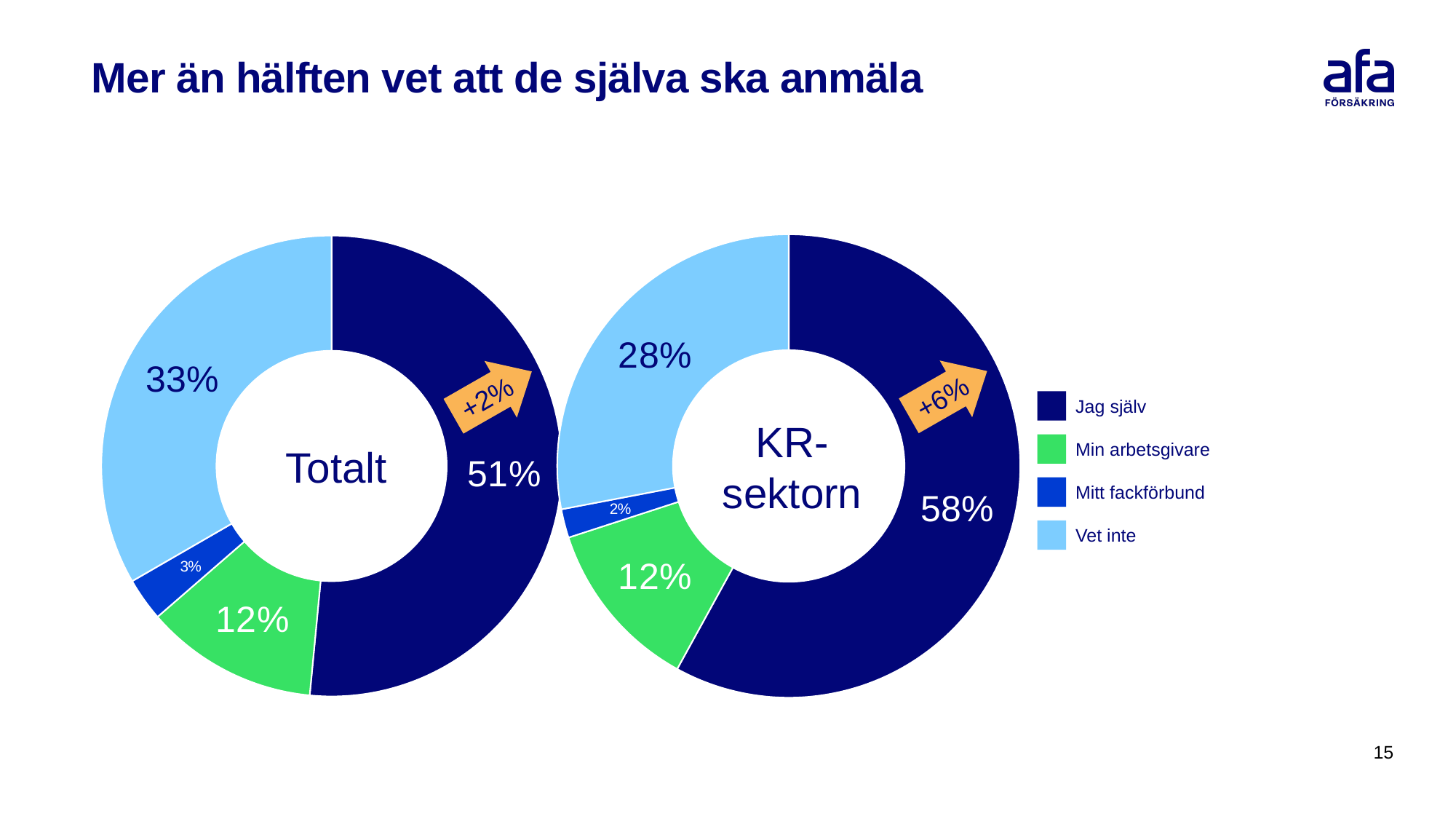
In the "Totalt" chart, which category has the largest slice? Jag själv What value is shown in the orange arrow on the "KR-sektorn" chart? +6% In the "Totalt" chart, what share is labelled for "Vet inte"? 33% Which chart has the larger "Vet inte" share, "Totalt" or "KR-sektorn"? Totalt How many categories does the legend list? 4 Which colour represents "Min arbetsgivare" in the legend? Green In the "KR-sektorn" chart, what share is labelled for "Jag själv"? 58% What kind of chart is used on this slide? Pie (donut) chart In the "KR-sektorn" chart, which category has the smallest slice? Mitt fackförbund What is the difference between the "Jag själv" share in the "KR-sektorn" chart and in the "Totalt" chart? 7 percentage points In the "Totalt" chart, what share is labelled for "Jag själv"? 51% In the "KR-sektorn" chart, what share is labelled for "Mitt fackförbund"? 2%